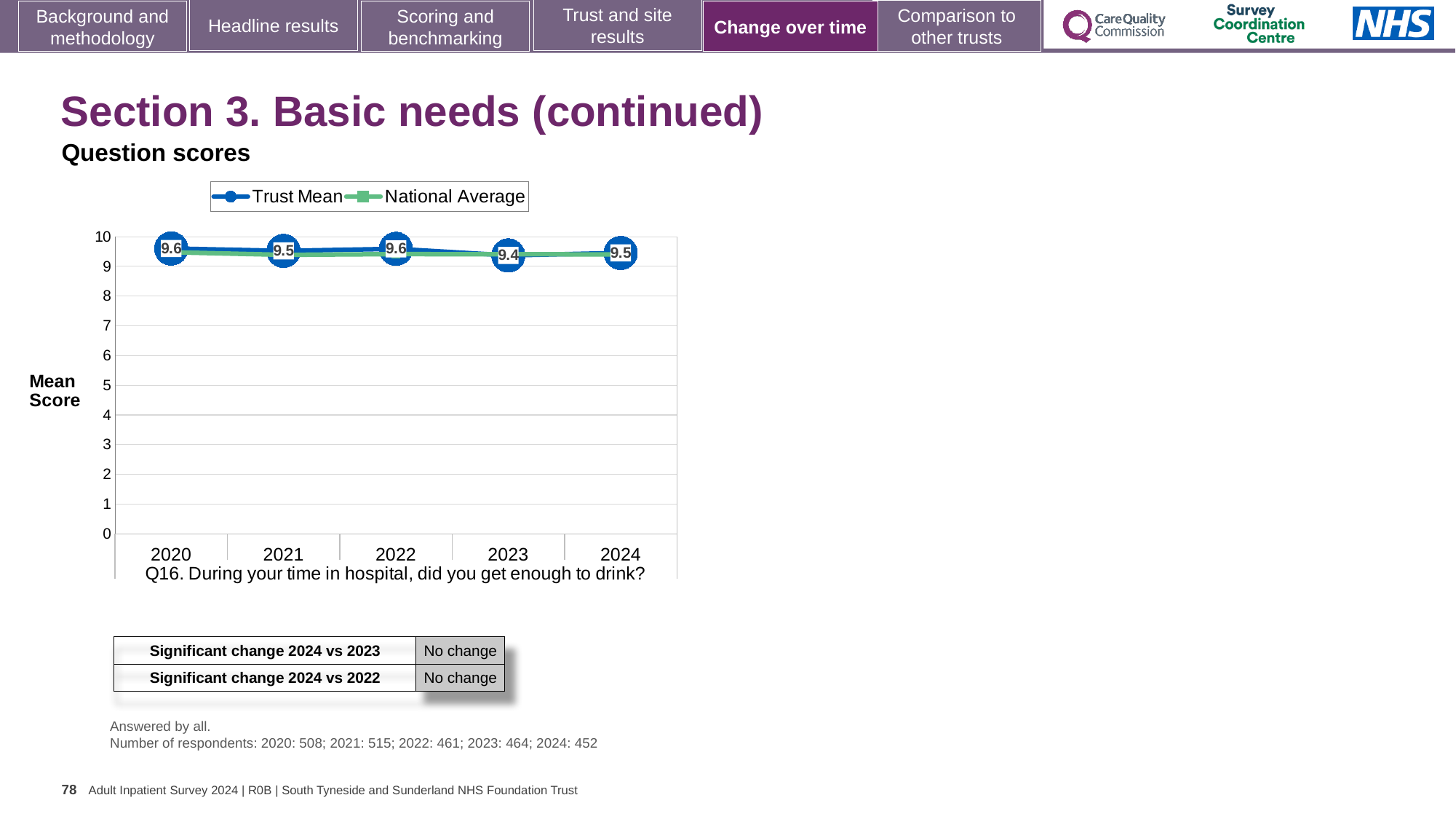
How many years are plotted on the x axis? 5 Is the National Average value for 2024 greater or less than 9? greater In which year is the Trust Mean score lowest? 2023 What is the Trust Mean score for 2023? 9.4 What kind of chart is shown on the slide? Line chart What is the Trust Mean score for 2024? 9.5 How many series does the legend list? 2 Did the Trust Mean score rise or fall from 2023 to 2024? Rise What is the difference between the Trust Mean scores for 2020 and 2023? 0.2 Which survey question does the chart show scores for? Q16. During your time in hospital, did you get enough to drink? Which year has the higher Trust Mean score, 2022 or 2023? 2022 What is the Trust Mean score for 2020? 9.6